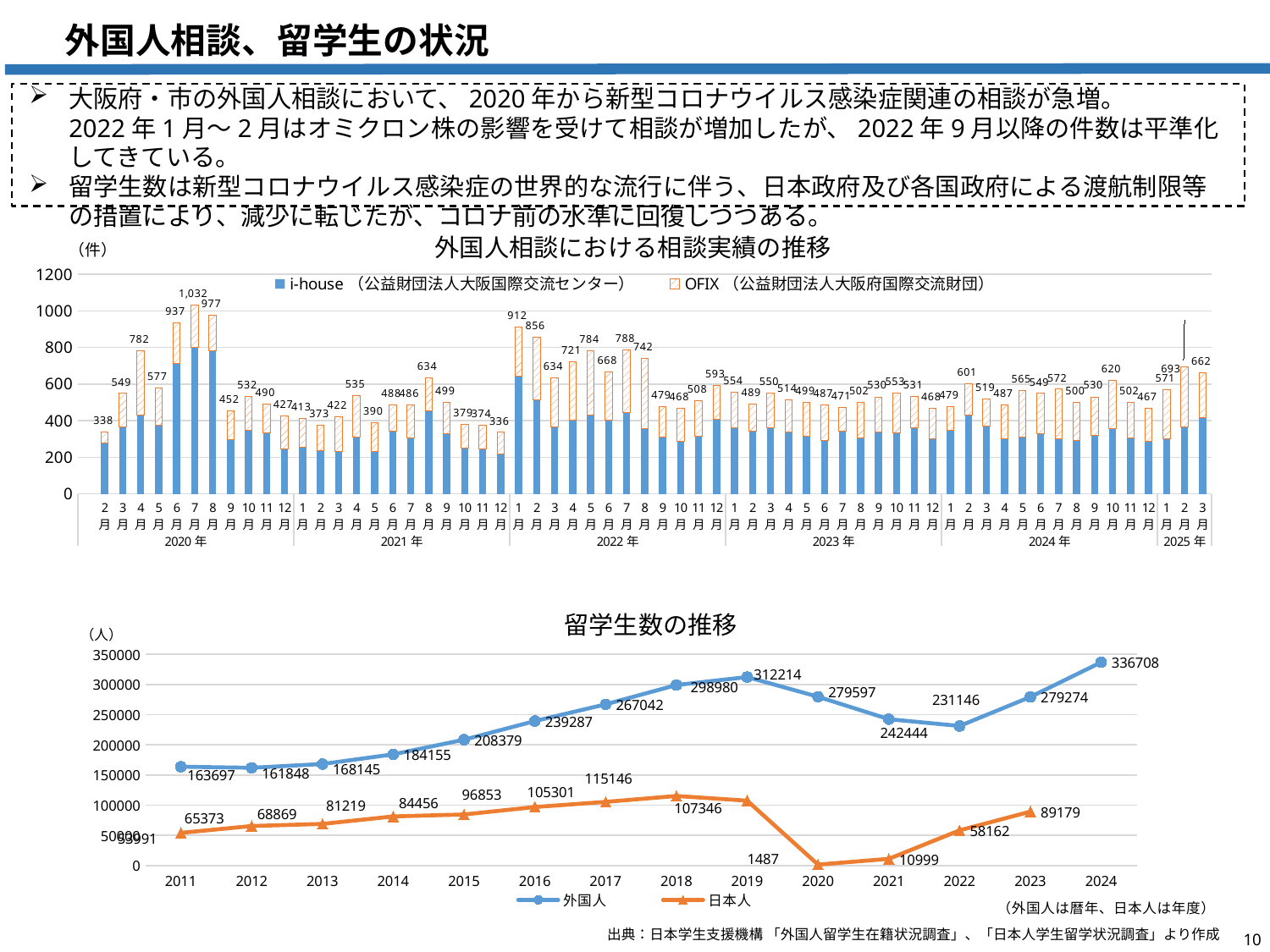
In the top chart (外国人相談における相談実績の推移), what is the total number of consultations labeled for 2020年7月? 1,032 In the bottom chart (留学生数の推移), what is the difference between the 外国人 values for 2019 and 2020? 32617 In the top chart (外国人相談における相談実績の推移), what is the total labeled for 2025年3月? 662 In the top chart (外国人相談における相談実績の推移), how many series does the legend list? 2 What kind of chart is the top chart (外国人相談における相談実績の推移)? Stacked bar chart In the top chart (外国人相談における相談実績の推移), what is the difference between the totals for 2020年7月 and 2020年8月? 55 In the bottom chart (留学生数の推移), which year has the lowest value for 日本人? 2020 What kind of chart is the bottom chart (留学生数の推移)? Line chart In the bottom chart (留学生数の推移), what is the value for 日本人 in 2020? 1487 In the top chart (外国人相談における相談実績の推移), what is the total labeled for 2022年1月? 912 In the bottom chart (留学生数の推移), what is the value for 外国人 in 2024? 336708 In the top chart (外国人相談における相談実績の推移), which month has the highest total? 2020年7月